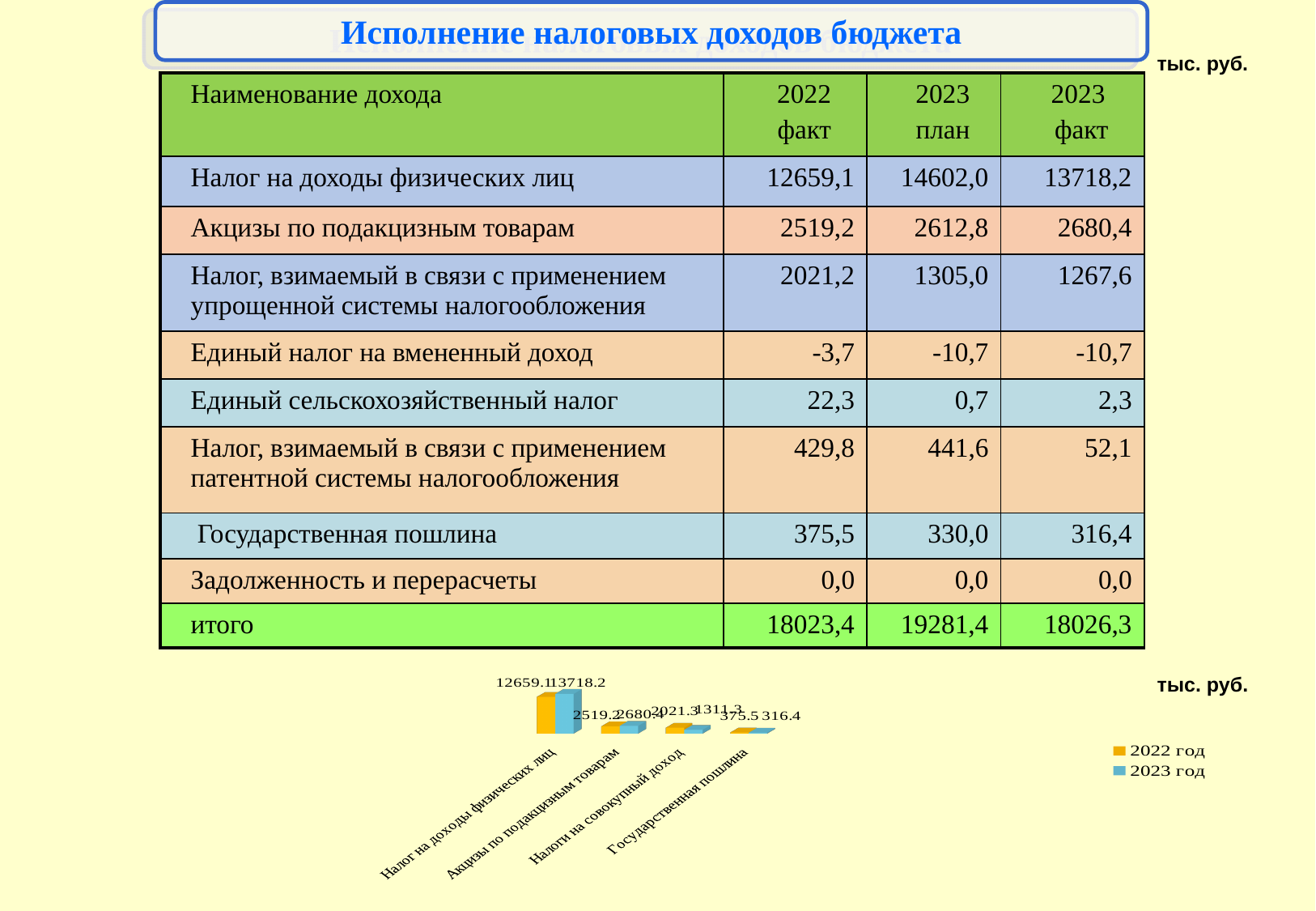
In the bar chart, what is the difference between the 2023 год and 2022 год values for Акцизы по подакцизным товарам? 161.2 In the bar chart, what is the value for Акцизы по подакцизным товарам in the 2023 год series? 2680.4 How many categories are shown on the x axis of the bar chart? 4 In the bar chart, what is the value for Налог на доходы физических лиц in the 2022 год series? 12659.1 In the bar chart, which category has the highest value in the 2023 год series? Налог на доходы физических лиц In the bar chart, what is the value for Государственная пошлина in the 2022 год series? 375.5 In the bar chart, which category has the lowest value in the 2022 год series? Государственная пошлина In the bar chart, what is the value for Налог на доходы физических лиц in the 2023 год series? 13718.2 What kind of chart is shown at the bottom of the slide? bar chart What are the two legend entries of the bar chart? 2022 год and 2023 год How many series does the legend of the bar chart list? 2 In the bar chart, which is larger for Государственная пошлина: the 2022 год value or the 2023 год value? 2022 год